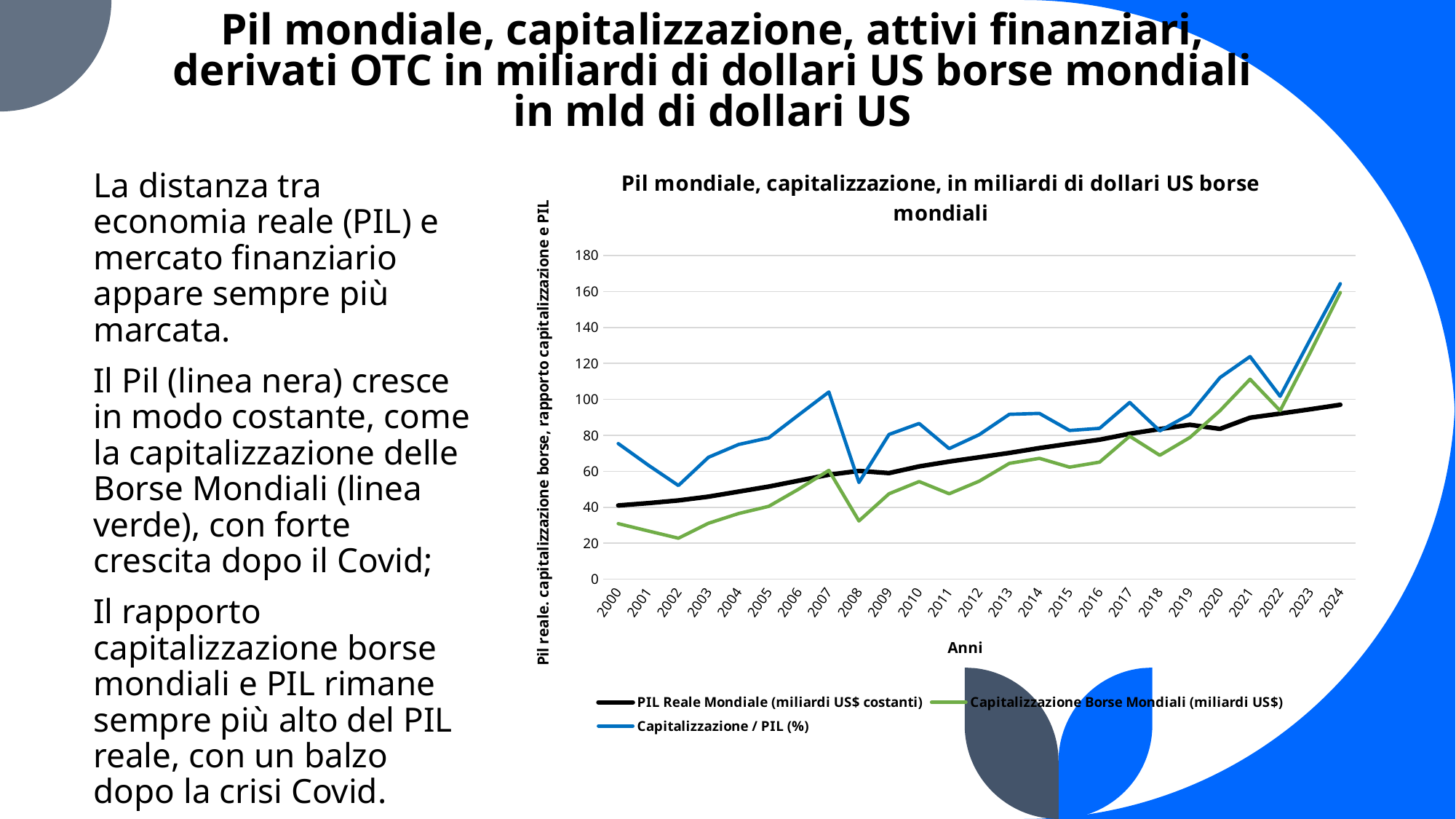
In which year does the Capitalizzazione / PIL (%) series reach its highest value? 2024 What is the label of the x axis of the chart? Anni Is the value of PIL Reale Mondiale in 2024 greater or less than 80? greater What kind of chart is shown on the slide? Line chart Is the value of Capitalizzazione / PIL (%) in 2021 greater or less than 100? greater How many years are plotted along the x axis of the chart? 25 In which year does the Capitalizzazione Borse Mondiali series reach its lowest value? 2002 Which series is drawn with the black line in the chart? PIL Reale Mondiale (miliardi US$ costanti) How many series does the chart legend list? 3 Is the value of PIL Reale Mondiale in 2000 greater or less than 60? less In 2024, which is larger: Capitalizzazione Borse Mondiali or PIL Reale Mondiale? Capitalizzazione Borse Mondiali